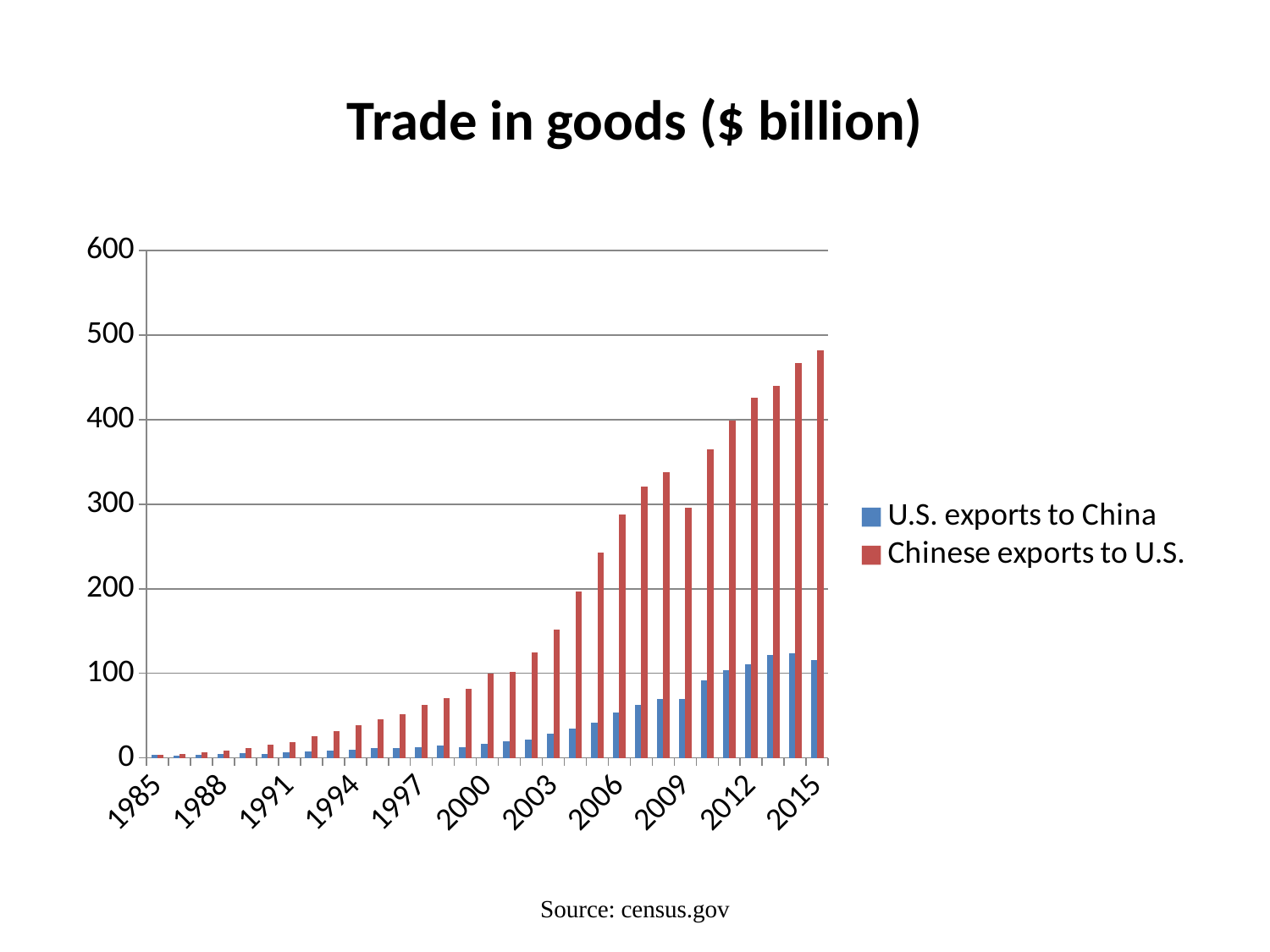
Is the value for Chinese exports to U.S. in 2006 greater or less than 200? greater What kind of chart is shown on the slide? bar chart In 2015, which is larger: U.S. exports to China or Chinese exports to U.S.? Chinese exports to U.S. Which series is shown in red? Chinese exports to U.S. How many year labels are shown on the x axis? 11 In which year are Chinese exports to U.S. highest? 2015 What is the title of the chart? Trade in goods ($ billion) How many series does the legend list? 2 Is the value for U.S. exports to China in 2015 greater or less than 200? less Is the value for Chinese exports to U.S. in 2015 greater or less than 400? greater Do Chinese exports to U.S. generally rise or fall from 1985 to 2015? rise